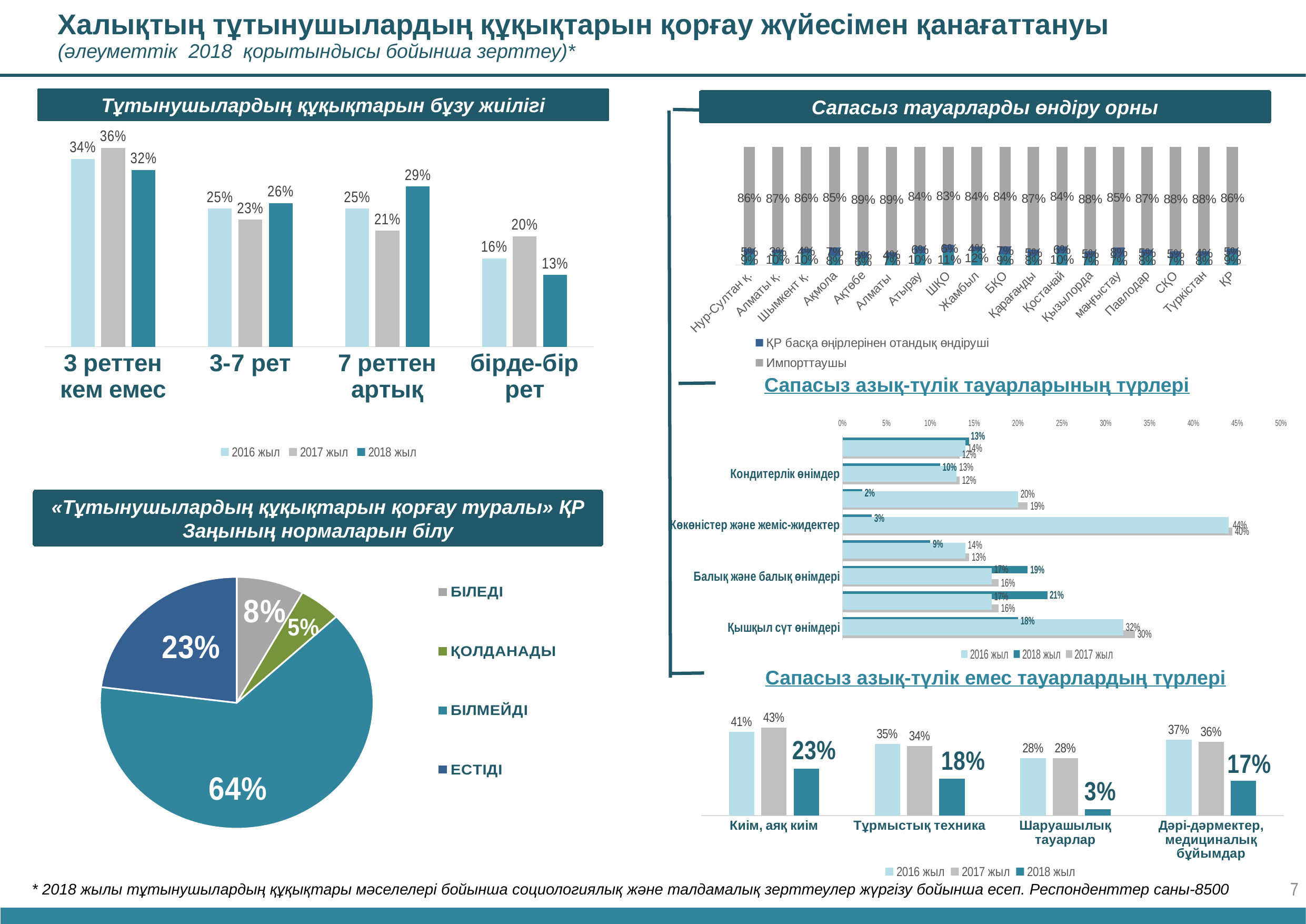
In the chart 'Сапасыз тауарларды өндіру орны', what is the 'Импорттаушы' value for 'ҚР'? 86% In the chart 'Сапасыз тауарларды өндіру орны', what is the 'Импорттаушы' value for 'ШҚО'? 83% In the chart 'Сапасыз азық-түлік емес тауарлардың түрлері', what is the value for 'Шаруашылық тауарлар' in 2018 жыл? 3% In the chart 'Тұтынушылардың құқықтарын бұзу жиілігі', what is the difference between the 2018 жыл and 2017 жыл values for '7 реттен артық'? 8% In the chart 'Тұтынушылардың құқықтарын бұзу жиілігі', what is the value for 'бірде-бір рет' in 2018 жыл? 13% What kind of chart is used for '«Тұтынушылардың құқықтарын қорғау туралы» ҚР Заңының нормаларын білу'? pie chart In the pie chart '«Тұтынушылардың құқықтарын қорғау туралы» ҚР Заңының нормаларын білу', what share does 'БІЛМЕЙДІ' have? 64% In the chart 'Сапасыз азық-түлік емес тауарлардың түрлері', which is larger for 'Дәрі-дәрмектер, медициналық бұйымдар': the 2016 жыл value or the 2018 жыл value? 2016 жыл In the chart 'Сапасыз азық-түлік емес тауарлардың түрлері', which category has the highest 2018 жыл value? Киім, аяқ киім In the chart 'Тұтынушылардың құқықтарын бұзу жиілігі', how many series does the legend list? 3 In the pie chart '«Тұтынушылардың құқықтарын қорғау туралы» ҚР Заңының нормаларын білу', which category has the smallest slice? ҚОЛДАНАДЫ In the chart 'Тұтынушылардың құқықтарын бұзу жиілігі', what is the value for '3 реттен кем емес' in 2017 жыл? 36%